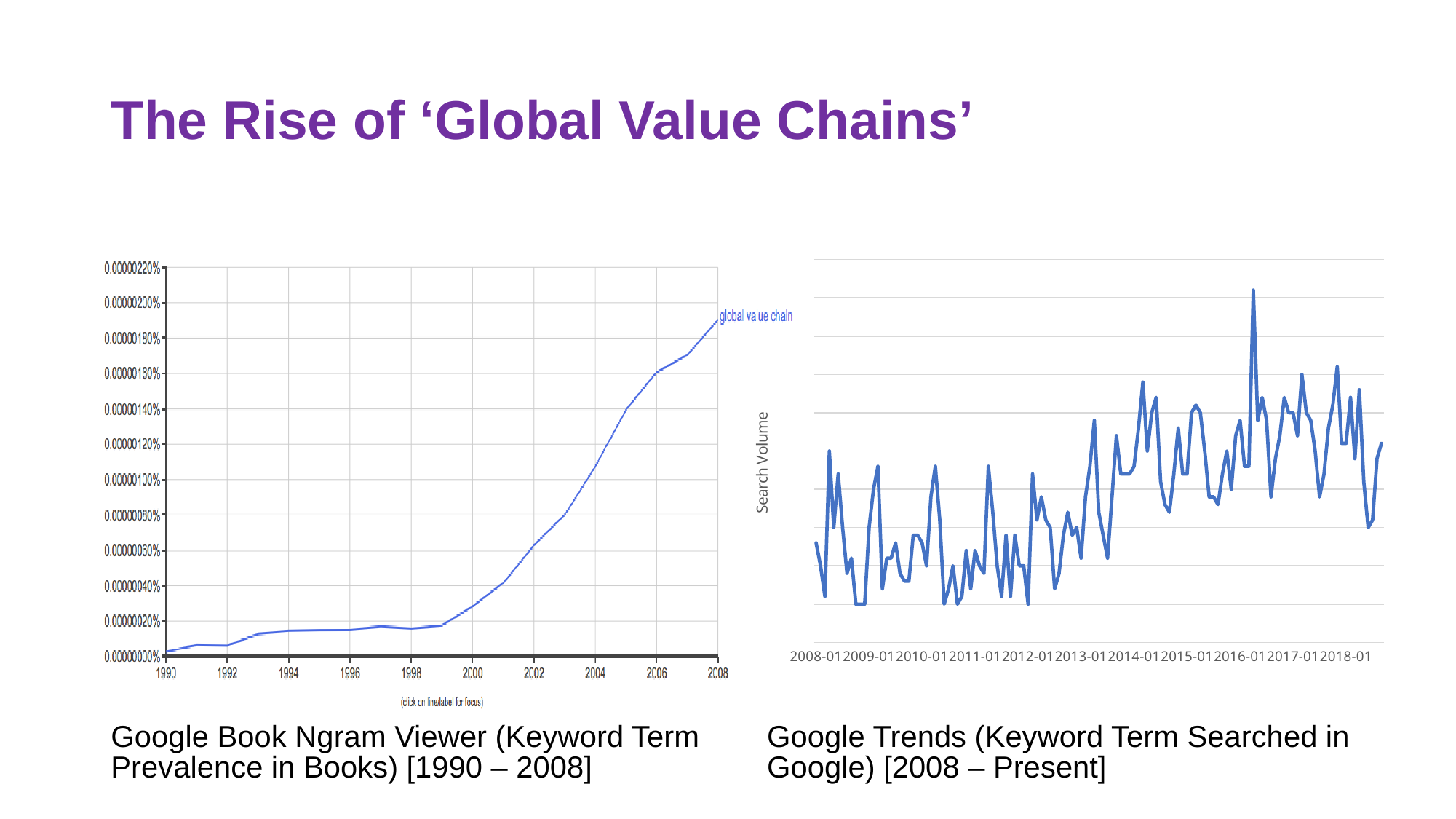
In the Google Book Ngram Viewer chart on the left, which is larger, the value for 2000 or the value for 2006? 2006 What kind of chart is the Google Book Ngram Viewer chart on the left? line chart In the Google Book Ngram Viewer chart on the left, which year shown on the x axis has the highest value? 2008 In the Google Book Ngram Viewer chart on the left, what is the label shown next to the plotted line? global value chain What kind of chart is the Google Trends chart on the right? line chart What is the y-axis label of the Google Trends chart on the right? Search Volume In the Google Book Ngram Viewer chart on the left, do the values generally rise or fall from 1990 to 2008? rise In the Google Trends chart on the right, do the values generally rise or fall from 2008-01 to 2018-01? rise